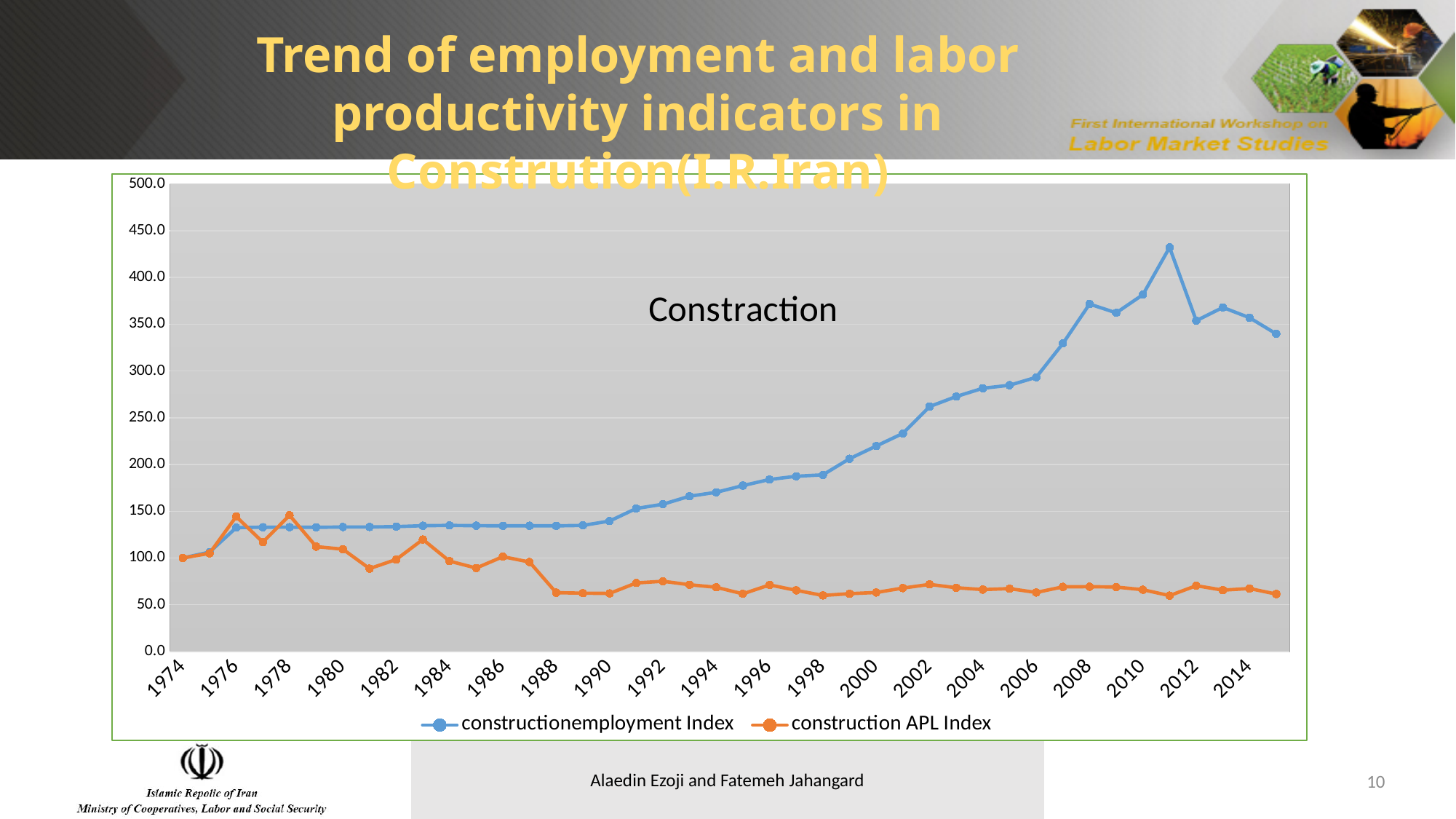
Is the construction employment Index value for 1990 greater or less than 150? less What kind of chart is shown on the slide? Line chart In 2014, which series has the higher value: construction employment Index or construction APL Index? constructionemployment Index In which year does the construction employment Index reach its highest value? 2011 What title is printed inside the chart's plot area? Constraction Does the construction APL Index generally rise or fall from 1974 to the end of the series? fall Is the construction employment Index value for 2004 greater or less than 250? greater Is the construction employment Index value for 2011 greater or less than 400? greater How many series does the chart legend list? 2 What are the two series named in the chart legend? constructionemployment Index and construction APL Index Does the construction employment Index generally rise or fall between 1990 and 2011? rise